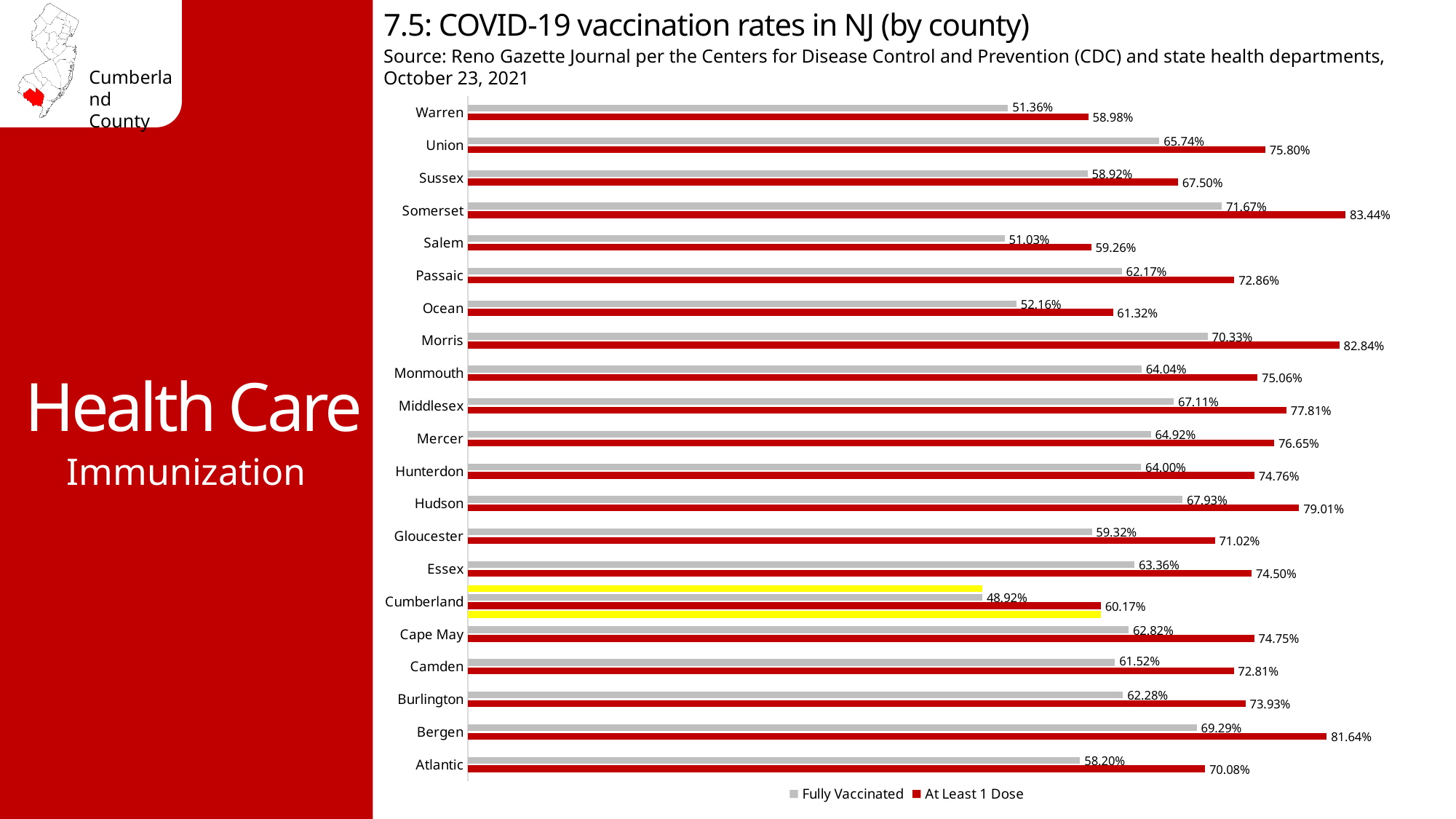
How many series does the legend list? 2 How many counties are shown in the chart? 21 What type of chart is shown on the slide? Bar chart Which county has the lowest Fully Vaccinated rate? Cumberland Which county has the highest Fully Vaccinated rate? Somerset What is the difference between the At Least 1 Dose rate and the Fully Vaccinated rate for Cumberland County? 11.25 percentage points Which county has the lowest At Least 1 Dose rate? Warren What is the At Least 1 Dose rate for Somerset County? 83.44% What is the Fully Vaccinated rate for Hudson County? 67.93% Which county has a higher Fully Vaccinated rate, Bergen or Morris? Morris Which series is shown in red in the chart? At Least 1 Dose What is the Fully Vaccinated rate for Cumberland County? 48.92%